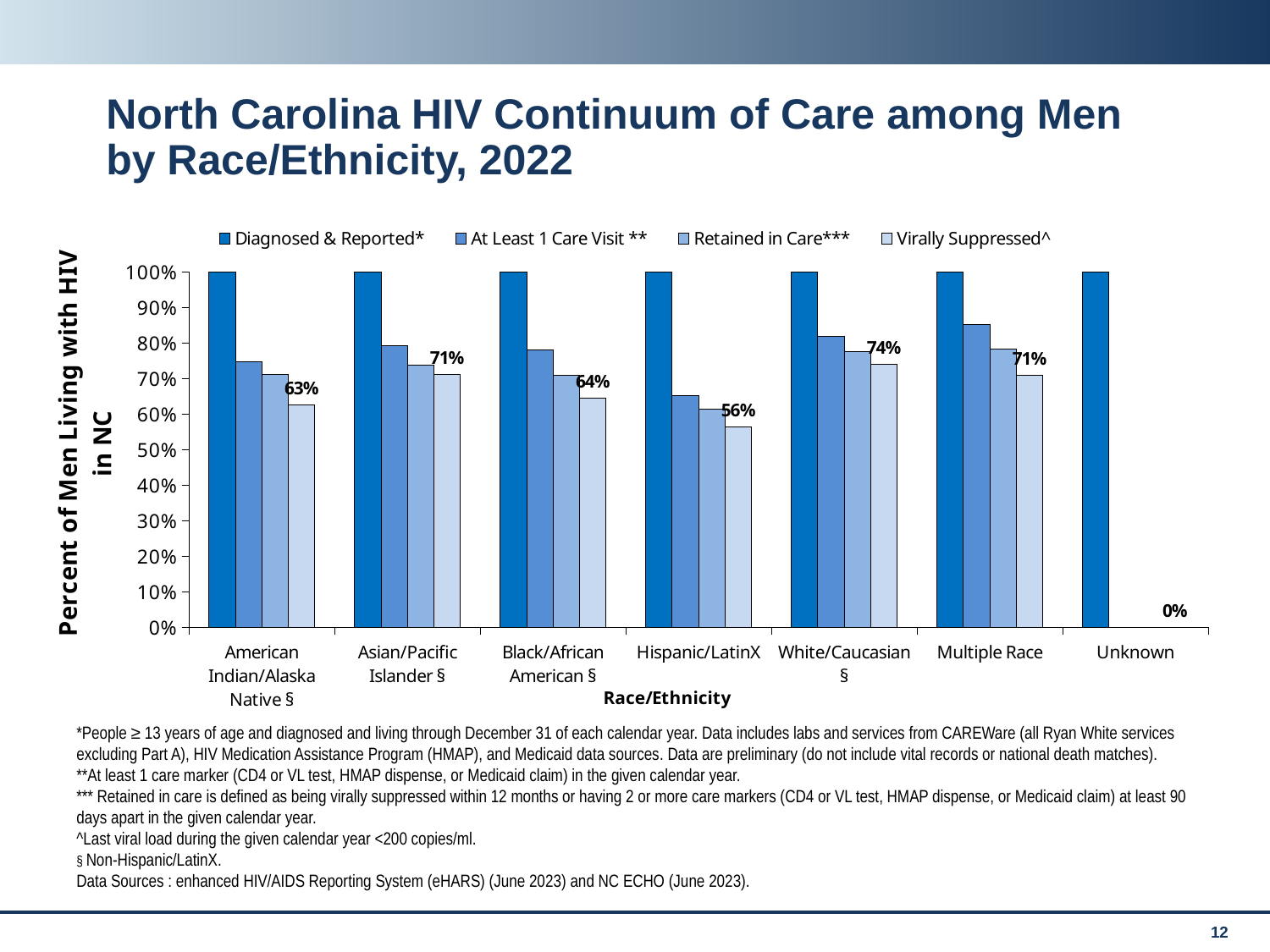
Excluding the Unknown category, which race/ethnicity has the lowest Virally Suppressed percentage? Hispanic/LatinX What is the Virally Suppressed value for White/Caucasian men? 74% What is the difference between the Virally Suppressed percentages for White/Caucasian and Hispanic/LatinX men? 18% What is the Virally Suppressed value for Hispanic/LatinX men? 56% What type of chart is shown on the slide? bar chart How many race/ethnicity categories are shown on the x axis? 7 Is the At Least 1 Care Visit value for Multiple Race men greater or less than 80%? greater What is the Virally Suppressed value for American Indian/Alaska Native men? 63% Which race/ethnicity category has the highest Virally Suppressed percentage? White/Caucasian What is the Diagnosed & Reported value for each race/ethnicity category? 100% How many series does the legend list? 4 Is the Virally Suppressed percentage higher for Black/African American men or for Asian/Pacific Islander men? Asian/Pacific Islander